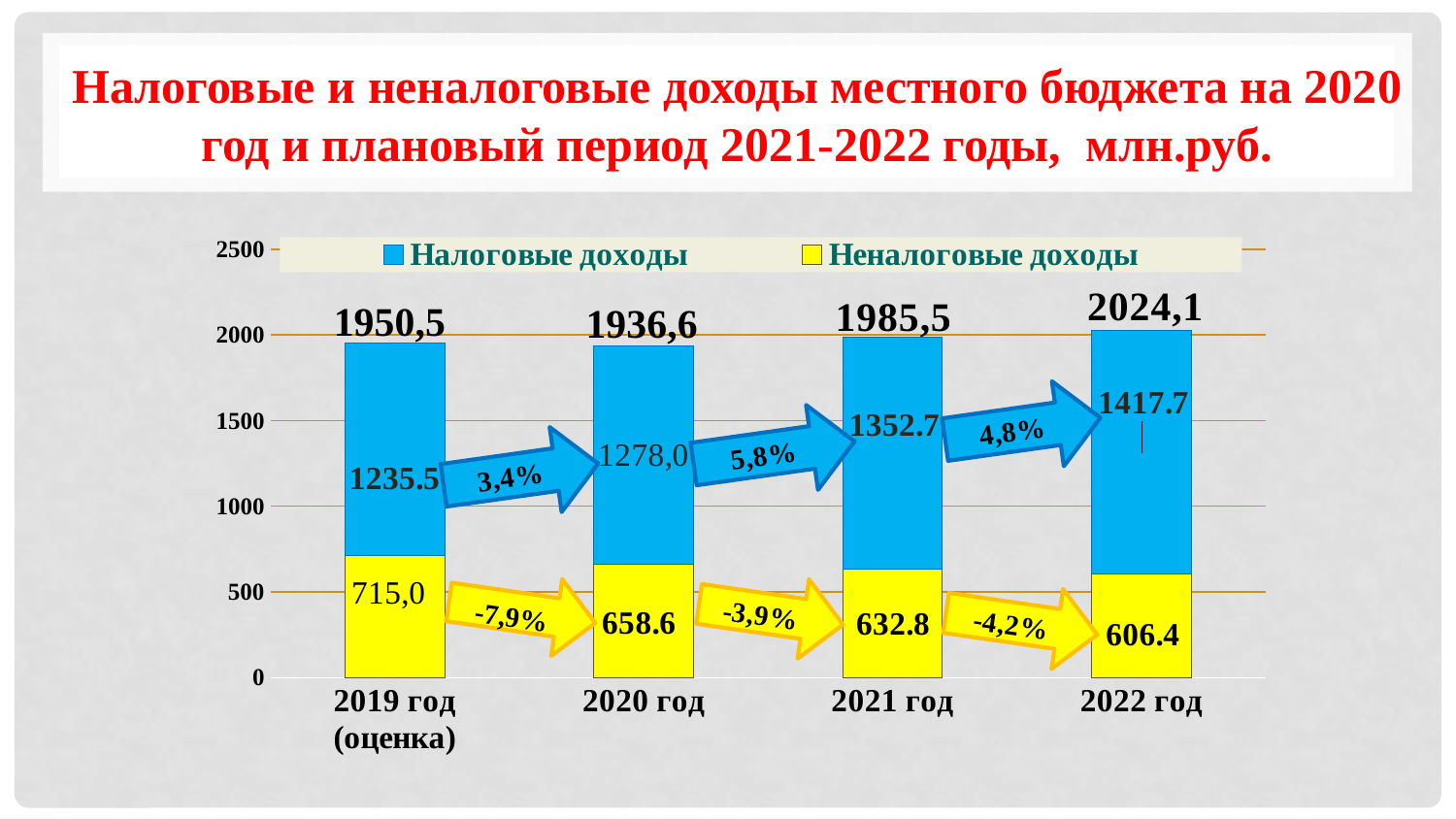
What is the value of Налоговые доходы for 2021 год? 1352.7 How many years (categories) are shown on the x axis? 4 What is the value of Неналоговые доходы for 2019 год (оценка)? 715,0 What is the total shown above the stacked bar for 2022 год? 2024,1 Which is larger: Неналоговые доходы in 2020 год or in 2021 год? 2020 год Which year has the highest value of Налоговые доходы? 2022 год What percentage change is shown on the arrow between Налоговые доходы for 2020 год and 2021 год? 5,8% Do the values of Неналоговые доходы rise or fall from 2019 год to 2022 год? fall What kind of chart is shown on the slide? stacked bar chart How many series does the legend list? 2 What is the difference between Налоговые доходы in 2022 год and in 2019 год (оценка)? 182.2 Which year has the lowest value of Неналоговые доходы? 2022 год